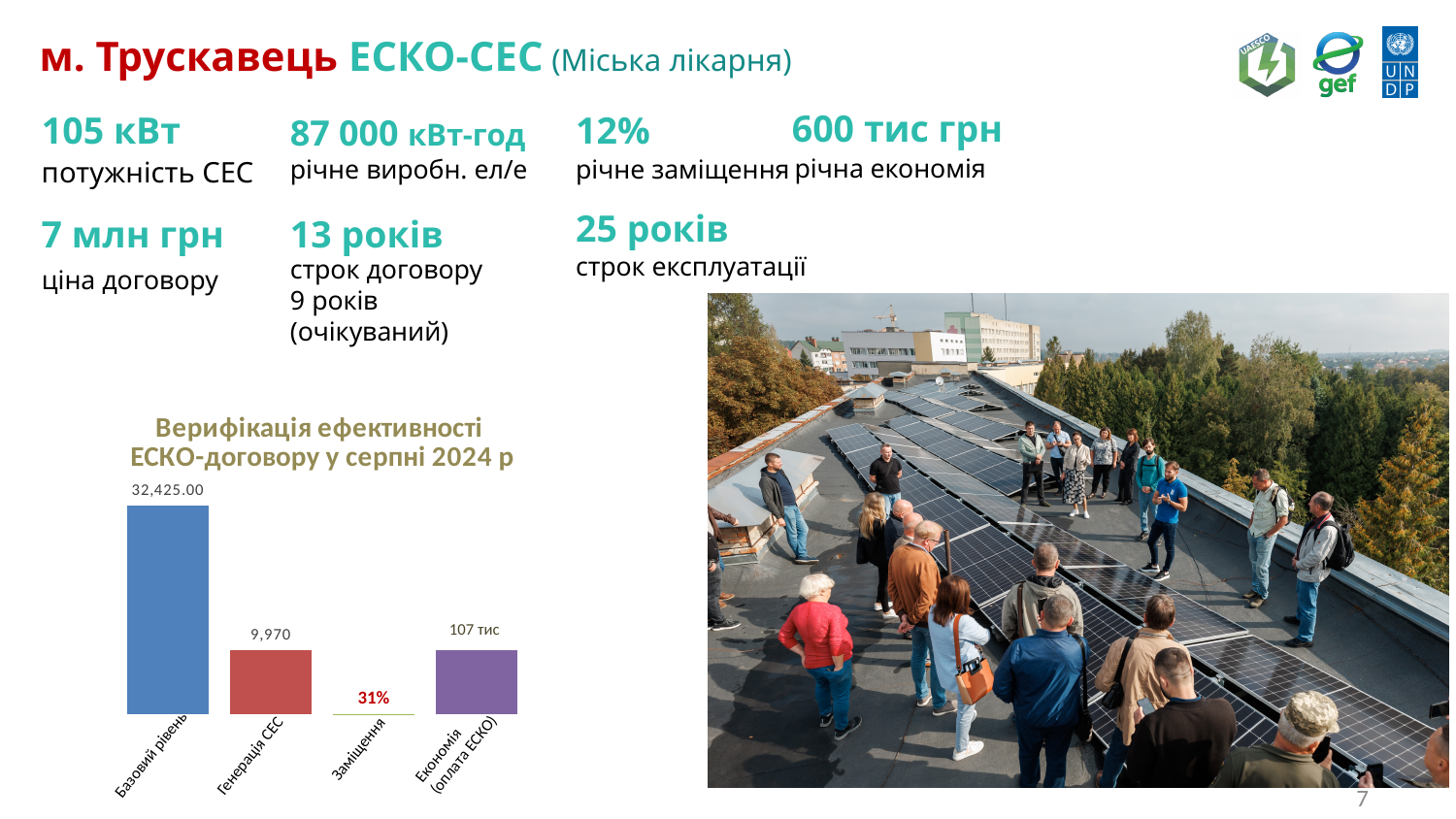
Which is larger in the chart, Базовий рівень or Генерація СЕС? Базовий рівень Which category has the tallest bar in the chart? Базовий рівень How many categories are shown in the chart? 4 What is the label shown for Заміщення in the chart? 31% What is the value for Базовий рівень in the chart? 32,425.00 What colour is the bar for Економія (оплата ЕСКО)? purple What is the difference between the values for Базовий рівень and Генерація СЕС? 22,455 What is the value for Генерація СЕС in the chart? 9,970 What type of chart is shown on the slide? bar chart What is the value for Економія (оплата ЕСКО) in the chart? 107 тис Which category has the shortest bar in the chart? Заміщення What is the title of the chart on the slide? Верифікація ефективності ЕСКО-договору у серпні 2024 р